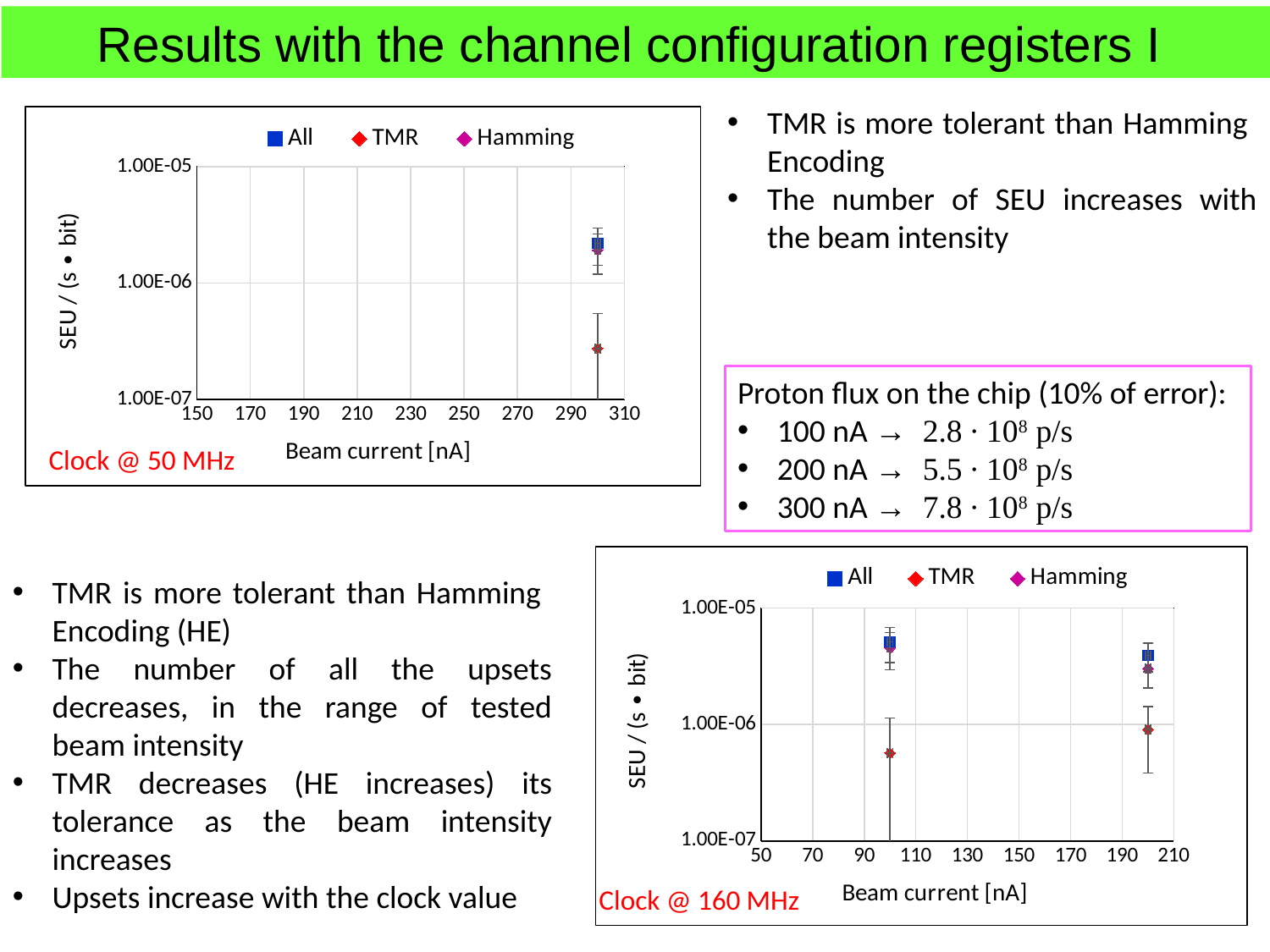
What kind of chart is the Clock @ 160 MHz chart? Scatter chart In the Clock @ 160 MHz chart, at how many beam current values are data points plotted? 2 In the Clock @ 50 MHz chart, how many series does the legend list? 3 In the Clock @ 50 MHz chart, which series has the lowest value at 300 nA? TMR In the Clock @ 50 MHz chart, is the TMR value at 300 nA greater or less than 1.00E-06? less In the Clock @ 160 MHz chart, does the All series rise or fall from 100 nA to 200 nA? fall In the Clock @ 50 MHz chart, is the All value at 300 nA greater or less than 1.00E-06? greater In the Clock @ 50 MHz chart, at how many beam current values are data points plotted? 1 In the Clock @ 160 MHz chart, is the TMR value larger at 100 nA or at 200 nA? 200 nA In the Clock @ 160 MHz chart, is the All value at 100 nA greater or less than 1.00E-06? greater In the Clock @ 160 MHz chart, what are the names of the series in the legend? All, TMR, Hamming